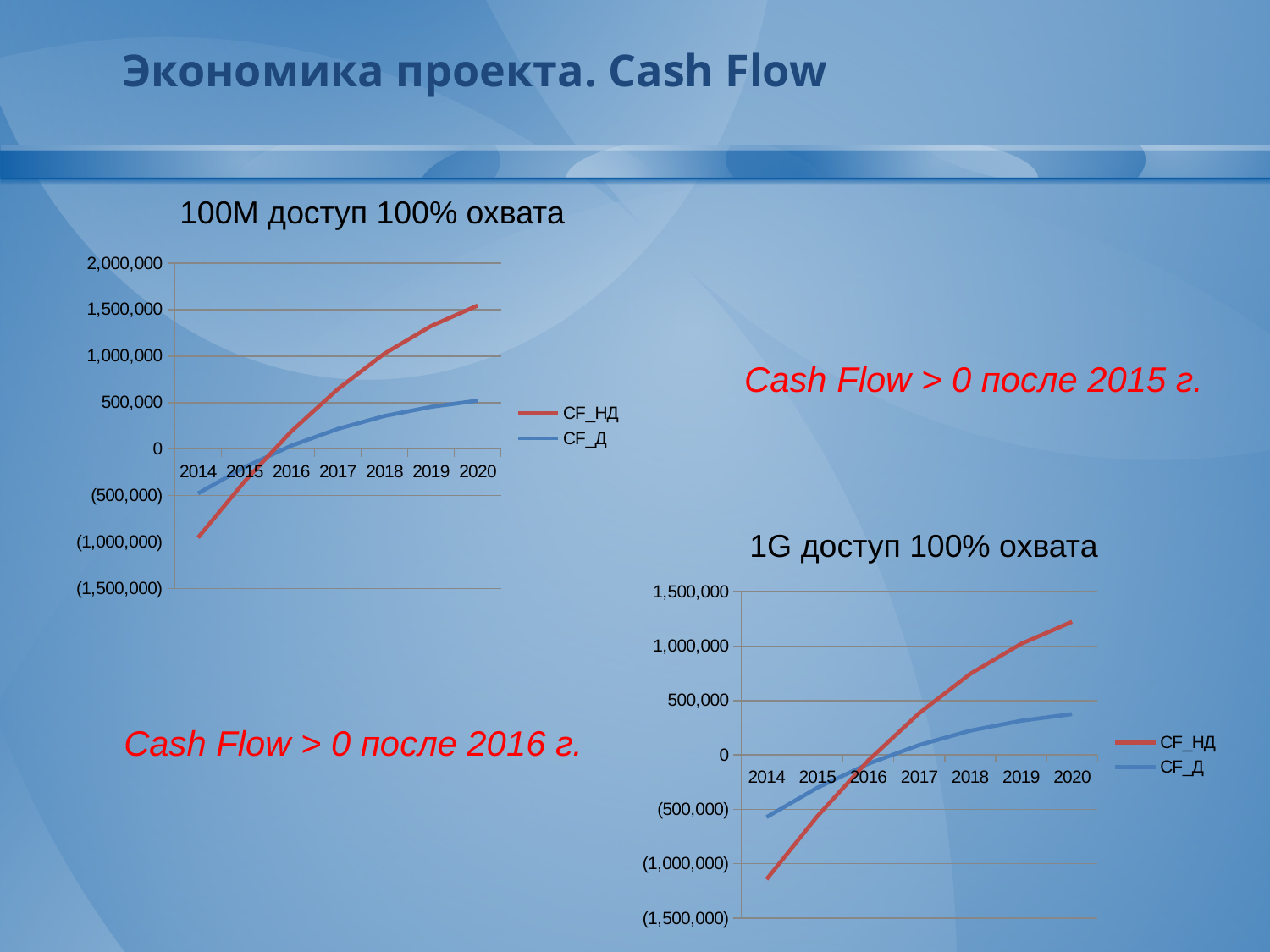
In the "1G доступ 100% охвата" chart, does the CF_Д series rise or fall from 2014 to 2020? rise What kind of chart is the "100M доступ 100% охвата" chart? line chart In the "100M доступ 100% охвата" chart, is the CF_НД value for 2020 greater or less than 1,000,000? greater In the "100M доступ 100% охвата" chart, which series has the higher value in 2020, CF_НД or CF_Д? CF_НД In the "1G доступ 100% охвата" chart, which series has the lower value in 2014, CF_НД or CF_Д? CF_НД How many years are plotted on the x axis of the "100M доступ 100% охвата" chart? 7 In the "1G доступ 100% охвата" chart, is the CF_Д value for 2020 greater or less than 500,000? less In the "100M доступ 100% охвата" chart, does the CF_НД series rise or fall from 2014 to 2020? rise In the "1G доступ 100% охвата" chart, what colour is the CF_НД line? red In the "100M доступ 100% охвата" chart, is the CF_Д value for 2020 greater or less than 1,000,000? less How many series does the legend of the "1G доступ 100% охвата" chart list? 2